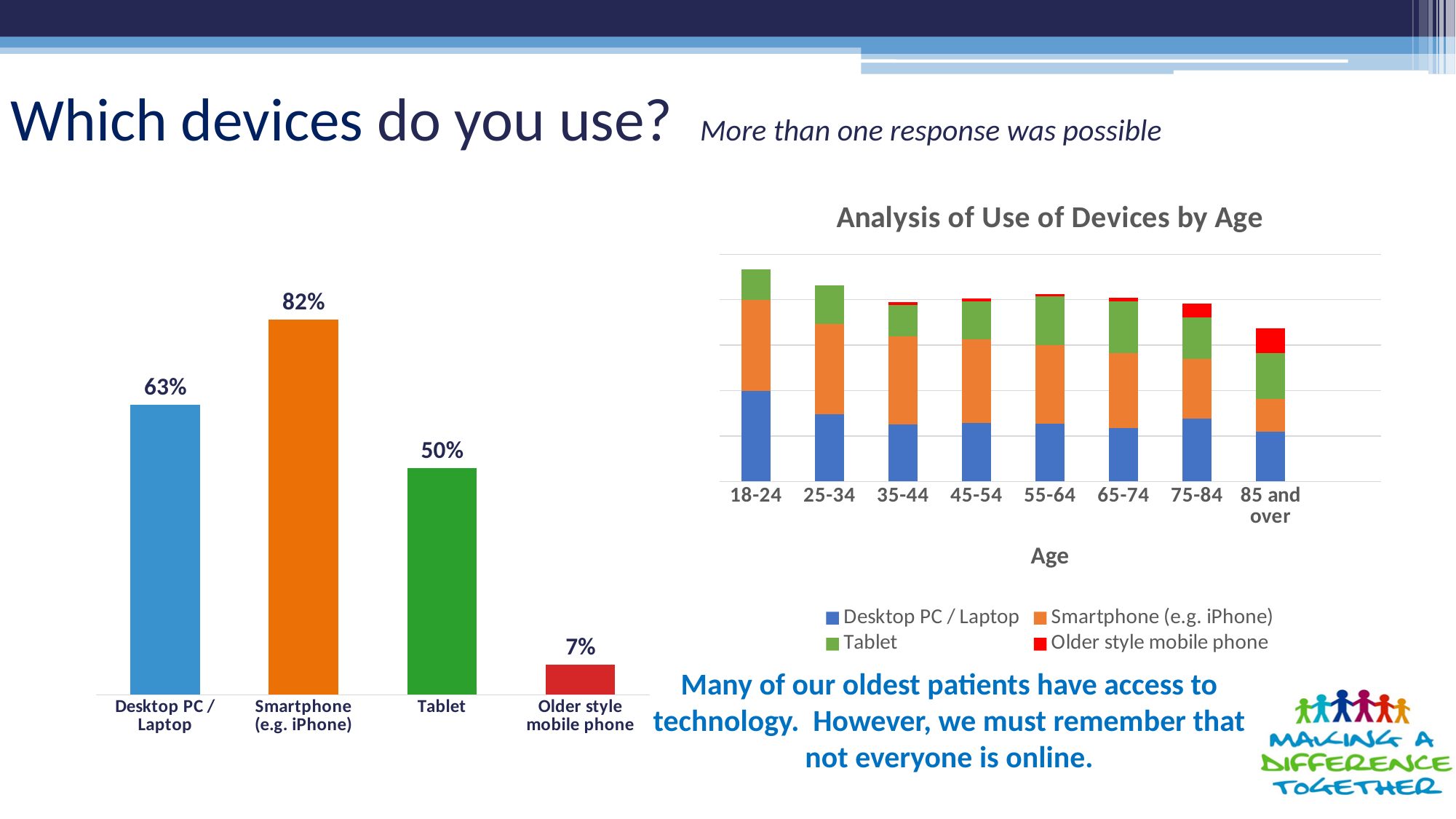
In the chart titled 'Analysis of Use of Devices by Age', how many age groups are shown on the x axis? 8 How many series does the legend of the 'Analysis of Use of Devices by Age' chart list? 4 What type of chart is 'Analysis of Use of Devices by Age'? Stacked bar chart In the left bar chart, what is the value for Tablet? 50% How many device categories are shown in the left bar chart? 4 In the left bar chart, which device has the lowest percentage? Older style mobile phone In the left bar chart, what is the difference between the Smartphone (e.g. iPhone) value and the Desktop PC / Laptop value? 19% In the left bar chart, what percentage of respondents use a Smartphone (e.g. iPhone)? 82% In the left bar chart, which device has the highest percentage? Smartphone (e.g. iPhone) In the left bar chart, which is larger: the value for Desktop PC / Laptop or the value for Tablet? Desktop PC / Laptop In the left bar chart, what is the value for Older style mobile phone? 7% In the 'Analysis of Use of Devices by Age' chart, which colour represents Older style mobile phone in the legend? Red